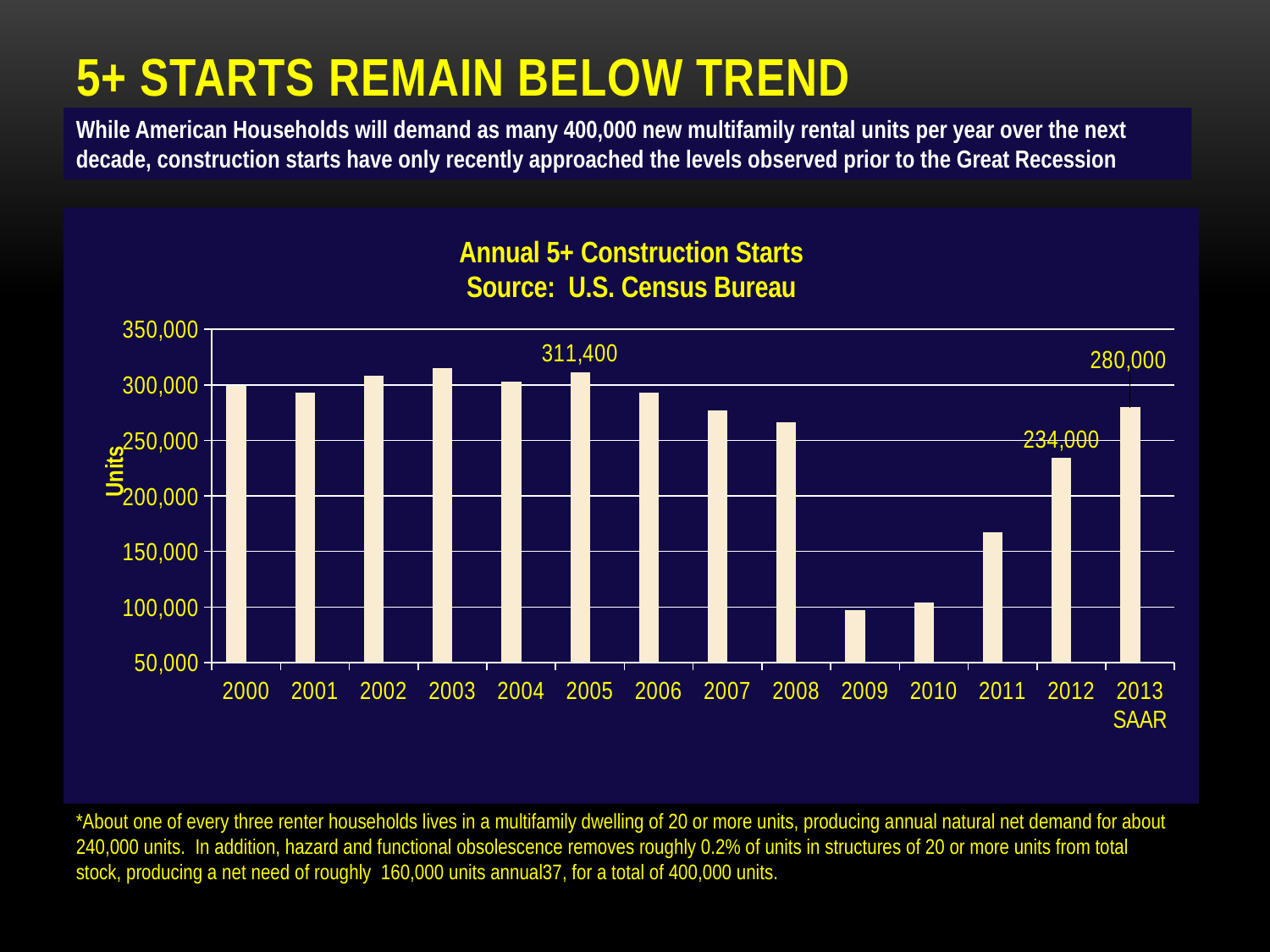
Do the values rise or fall from 2005 to 2009? fall Which year has the lowest value in the Annual 5+ Construction Starts chart? 2009 What is the value for 2012 in the Annual 5+ Construction Starts chart? 234,000 Is the value for 2011 greater or less than 150,000? greater What is the difference between the 2005 value and the 2012 value? 77,400 What is the value for 2005 in the Annual 5+ Construction Starts chart? 311,400 What is the difference between the 2013 SAAR value and the 2012 value? 46,000 Which is larger, the value for 2005 or the value for 2013 SAAR? 2005 What is the value for 2013 SAAR in the Annual 5+ Construction Starts chart? 280,000 How many years (bars) are shown in the Annual 5+ Construction Starts chart? 14 What kind of chart is used to show Annual 5+ Construction Starts? bar chart